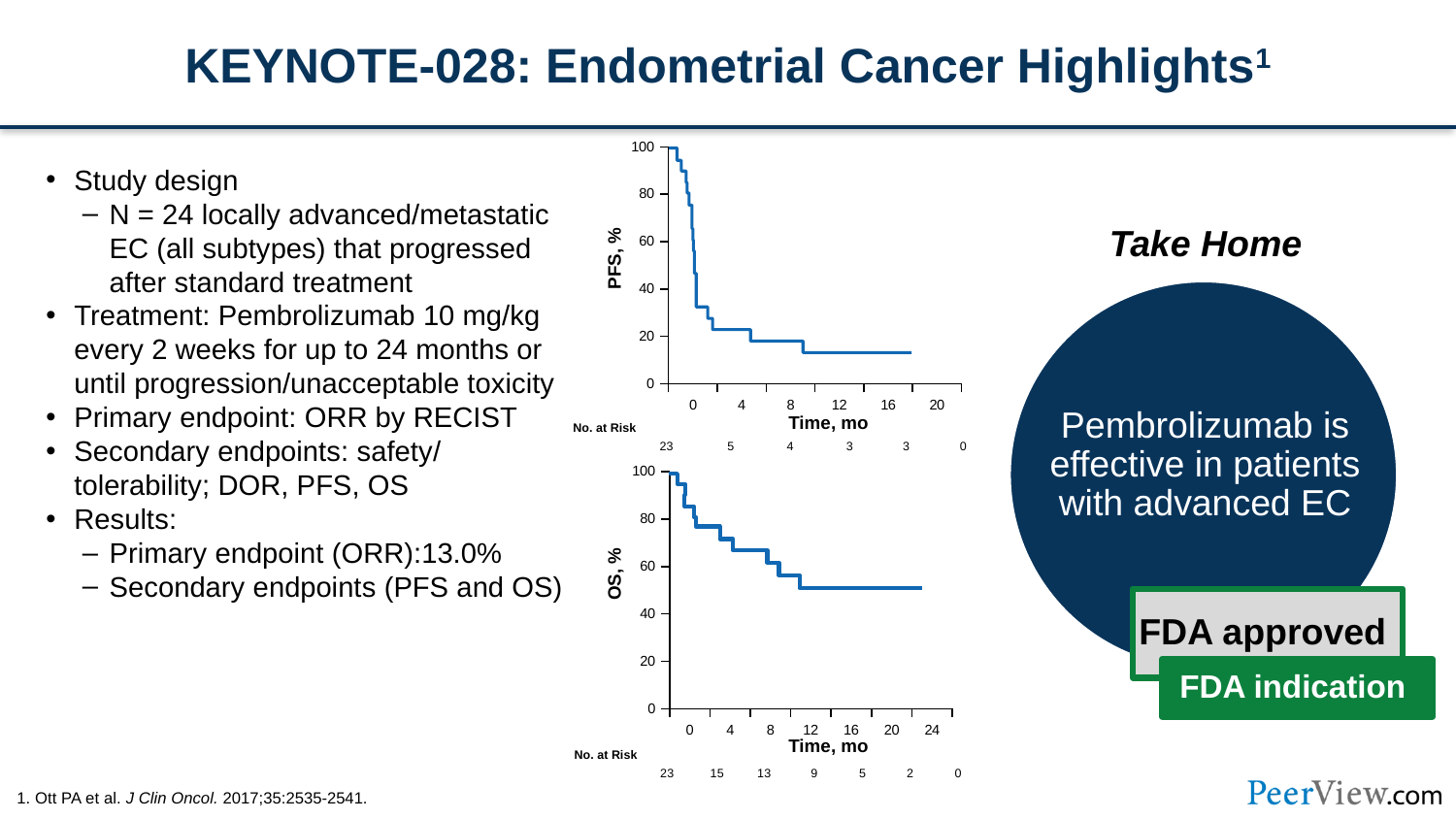
In the bottom chart (OS), what is the highest value shown on the x axis (Time, mo)? 24 In the bottom chart (OS), what is the number at risk at 8 months? 13 What kind of chart is the top chart (PFS, %)? line chart In the bottom chart (OS), is the value at 16 months greater or less than 60? less In the top chart, what is the label of the y axis? PFS, % In the top chart (PFS), what is the number at risk at time 0? 23 In the top chart (PFS), is the value at 12 months greater or less than 20? less In the top chart (PFS), does the curve rise or fall as time increases? fall In the bottom chart (OS), what is the difference between the number at risk at 4 months and at 12 months? 6 In the bottom chart, what is the label of the y axis? OS, % In the bottom chart (OS), is the value at 20 months greater or less than 40? greater In the bottom chart (OS), does the curve rise or fall as time increases? fall